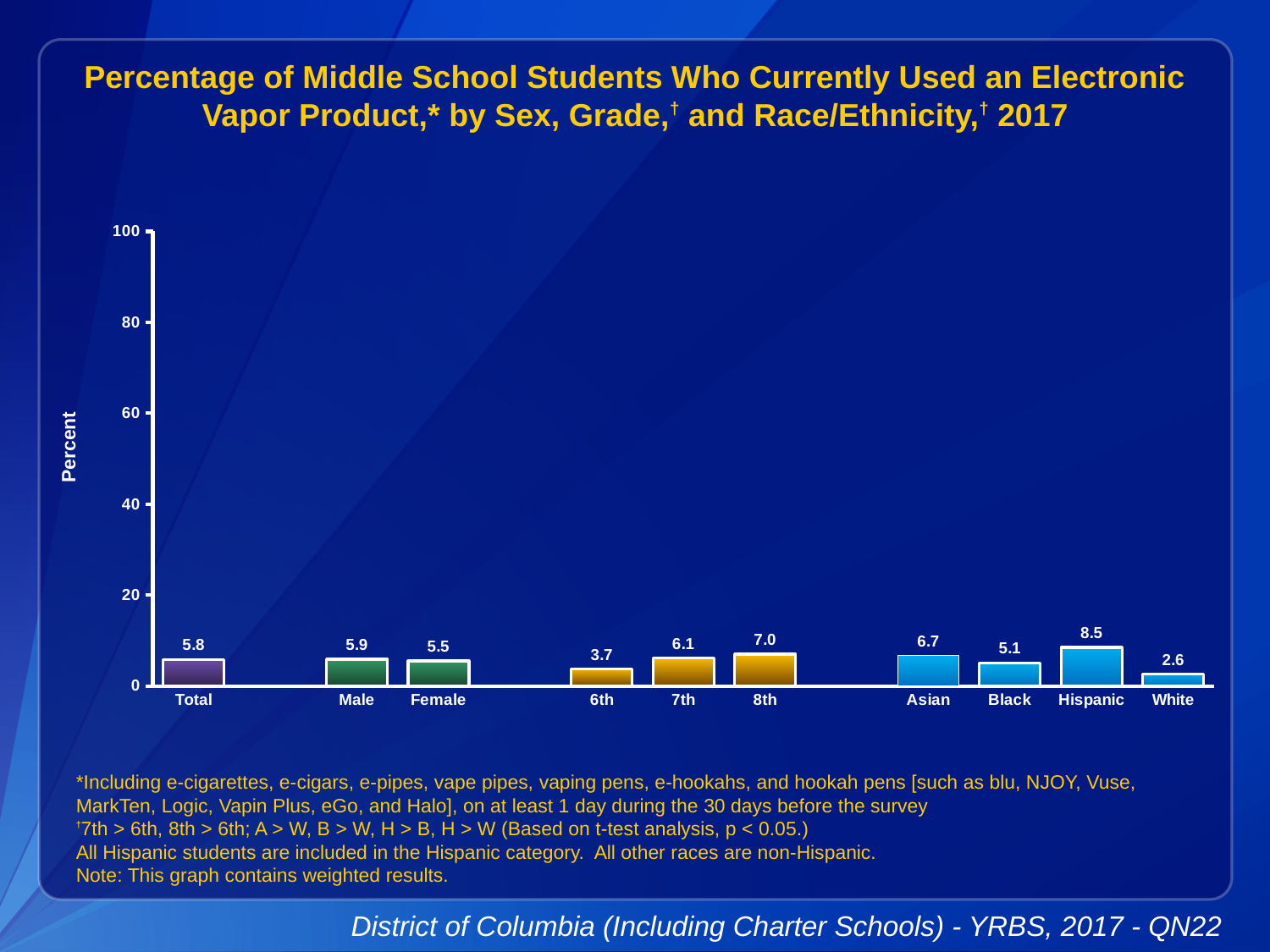
What is the difference between the values for Male and Female? 0.4 Which is larger, the value for Asian or the value for Black? Asian What is the value for Hispanic students? 8.5 What kind of chart is shown on the slide? bar chart What is the difference between the values for 8th grade and 6th grade? 3.3 Which category has the highest value? Hispanic What is the value for 6th grade? 3.7 Is the value for 7th grade greater or less than 20? less Do the values rise or fall from 6th grade to 8th grade? rise How many bars are shown in the chart? 10 Which category has the lowest value? White What is the value for Total? 5.8